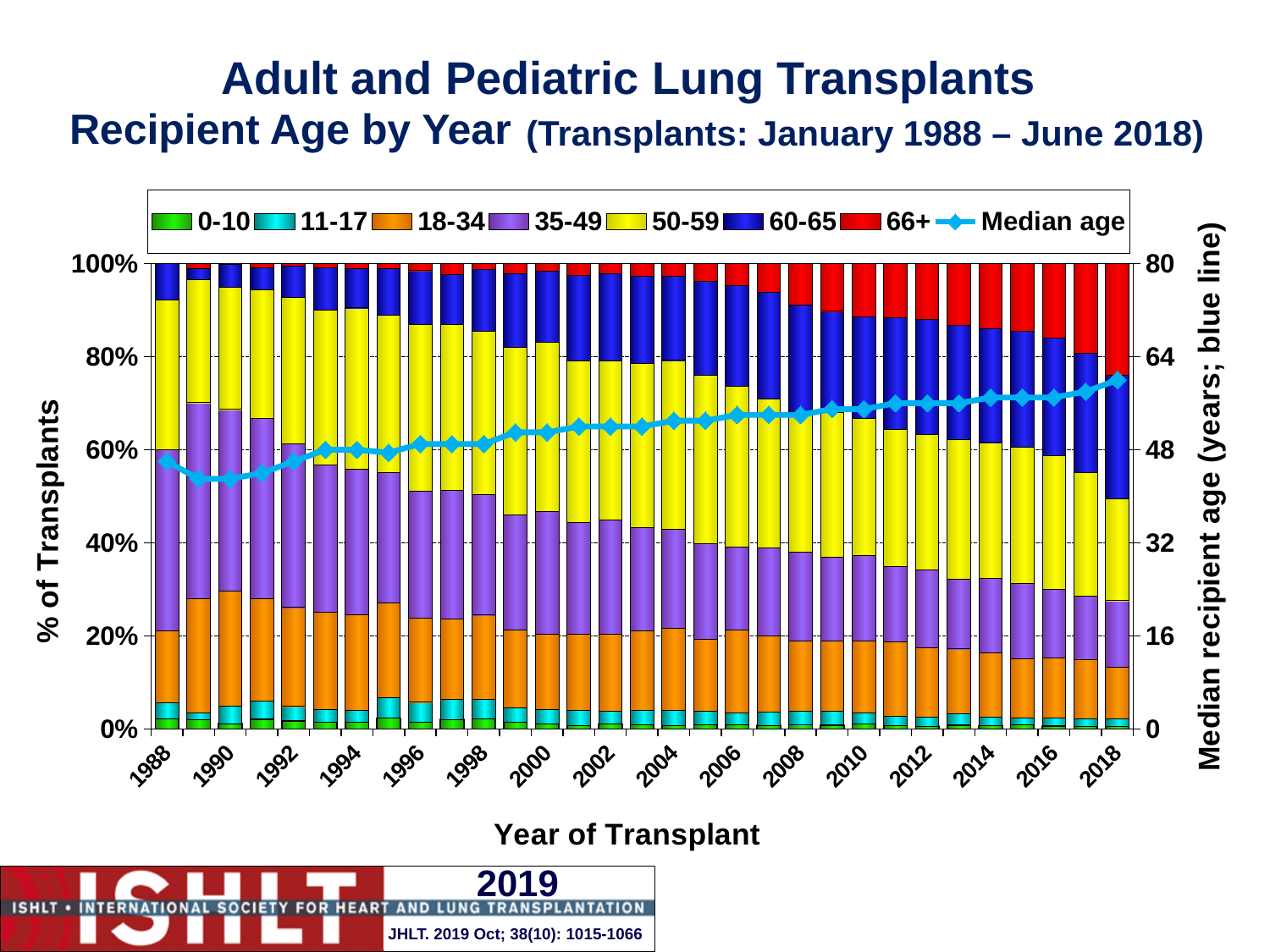
Is the share of transplants for recipients aged 35-49 larger in 1988 or in 2018? 1988 Which legend entry is plotted as a line rather than as bar segments? Median age How many entries does the legend list? 8 What kind of chart is shown on the slide? Stacked bar chart with a line Which year has the highest median recipient age? 2018 Is the median recipient age in 2018 greater or less than 48 years? greater Is the share of transplants for recipients aged 66+ in 1988 greater or less than 20%? less Is the share of transplants for recipients aged 66+ larger in 1988 or in 2018? 2018 Does the median recipient age generally rise or fall from 1988 to 2018? Rise What is the title of the right-hand vertical axis? Median recipient age (years; blue line) How many years (bars) are plotted along the x axis? 31 Is the median recipient age in 1989 greater or less than 48 years? less